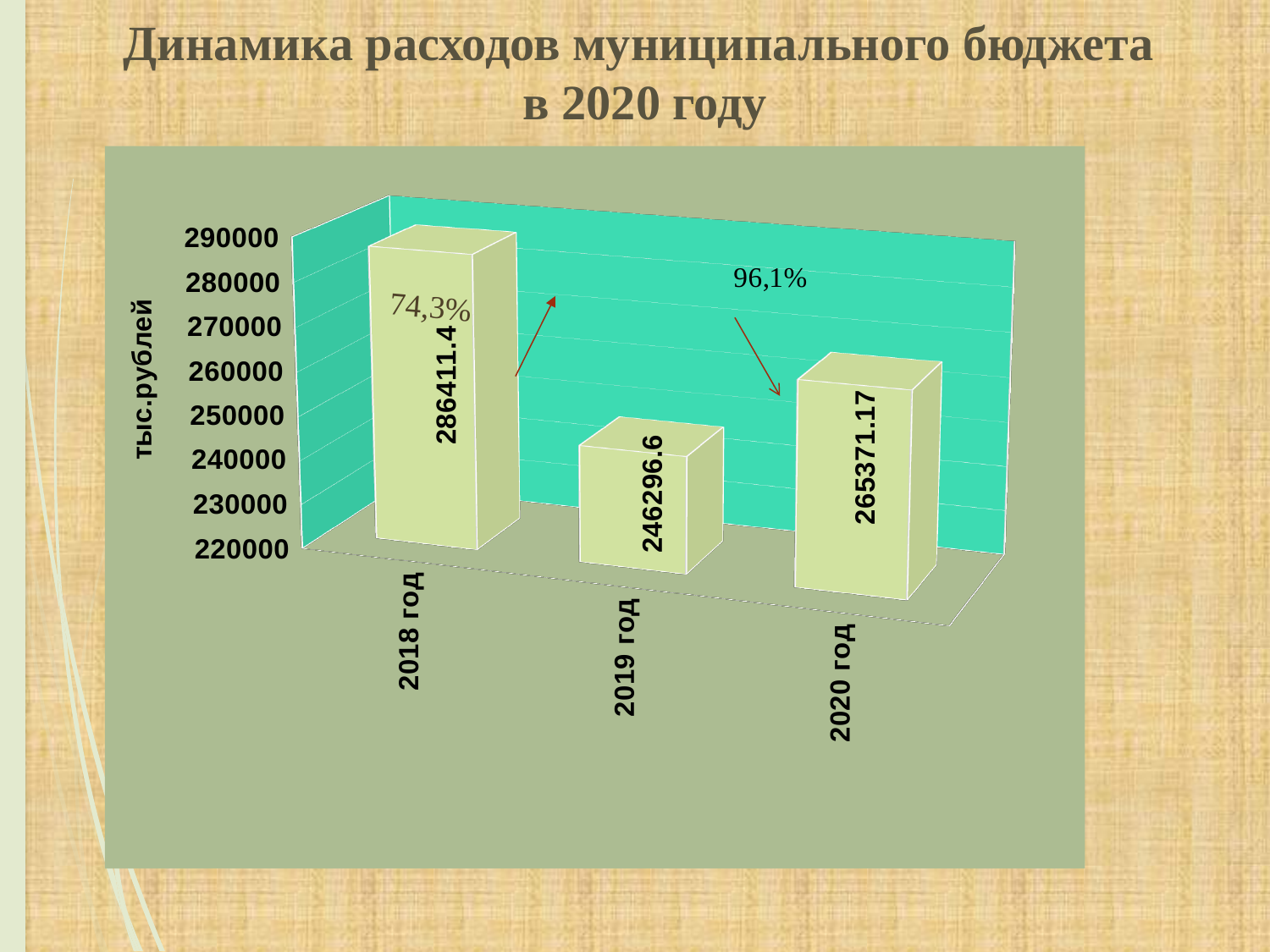
What is the difference between the values for 2020 год and 2019 год? 19074.57 What is the value for 2018 год? 286411.4 What kind of chart is shown on the slide? bar chart What is the label of the vertical axis? тыс.рублей What is the value for 2020 год? 265371.17 How many years are shown on the chart? 3 Which year has the highest expenditure? 2018 год Is the value for 2019 год greater or less than 250000? less Which is larger, the value for 2020 год or the value for 2019 год? 2020 год What is the value for 2019 год? 246296.6 What is the difference between the values for 2018 год and 2019 год? 40114.8 Which year has the lowest expenditure? 2019 год